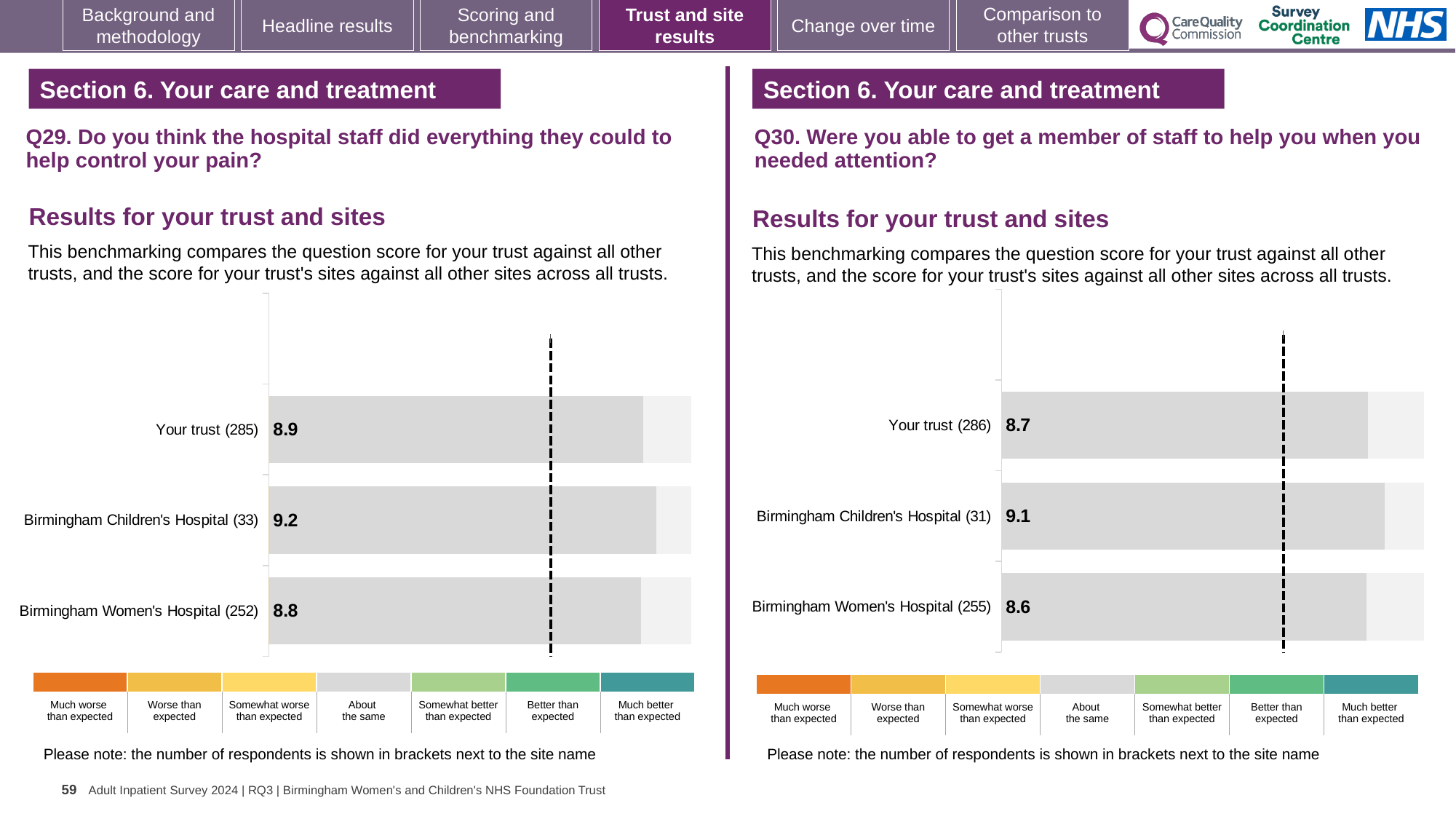
In the Q29 chart on the left, what is the score for Your trust? 8.9 In the Q29 chart on the left, what is the score for Birmingham Children's Hospital? 9.2 In the Q30 chart on the right, how many respondents are shown in brackets for Birmingham Children's Hospital? 31 What type of chart is used in the Q29 chart on the left? Bar chart In the Q30 chart on the right, what is the difference between the scores for Birmingham Children's Hospital and Your trust? 0.4 In the Q30 chart on the right, which site or trust has the highest score? Birmingham Children's Hospital In the Q29 chart on the left, how many bars are plotted? 3 In the Q30 chart on the right, what is the score for Your trust? 8.7 In the Q29 chart on the left, what is the difference between the scores for Birmingham Children's Hospital and Birmingham Women's Hospital? 0.4 In the Q30 chart on the right, what is the score for Birmingham Women's Hospital? 8.6 In the Q30 chart on the right, which has the larger score: Your trust or Birmingham Women's Hospital? Your trust In the Q29 chart on the left, which site or trust has the lowest score? Birmingham Women's Hospital